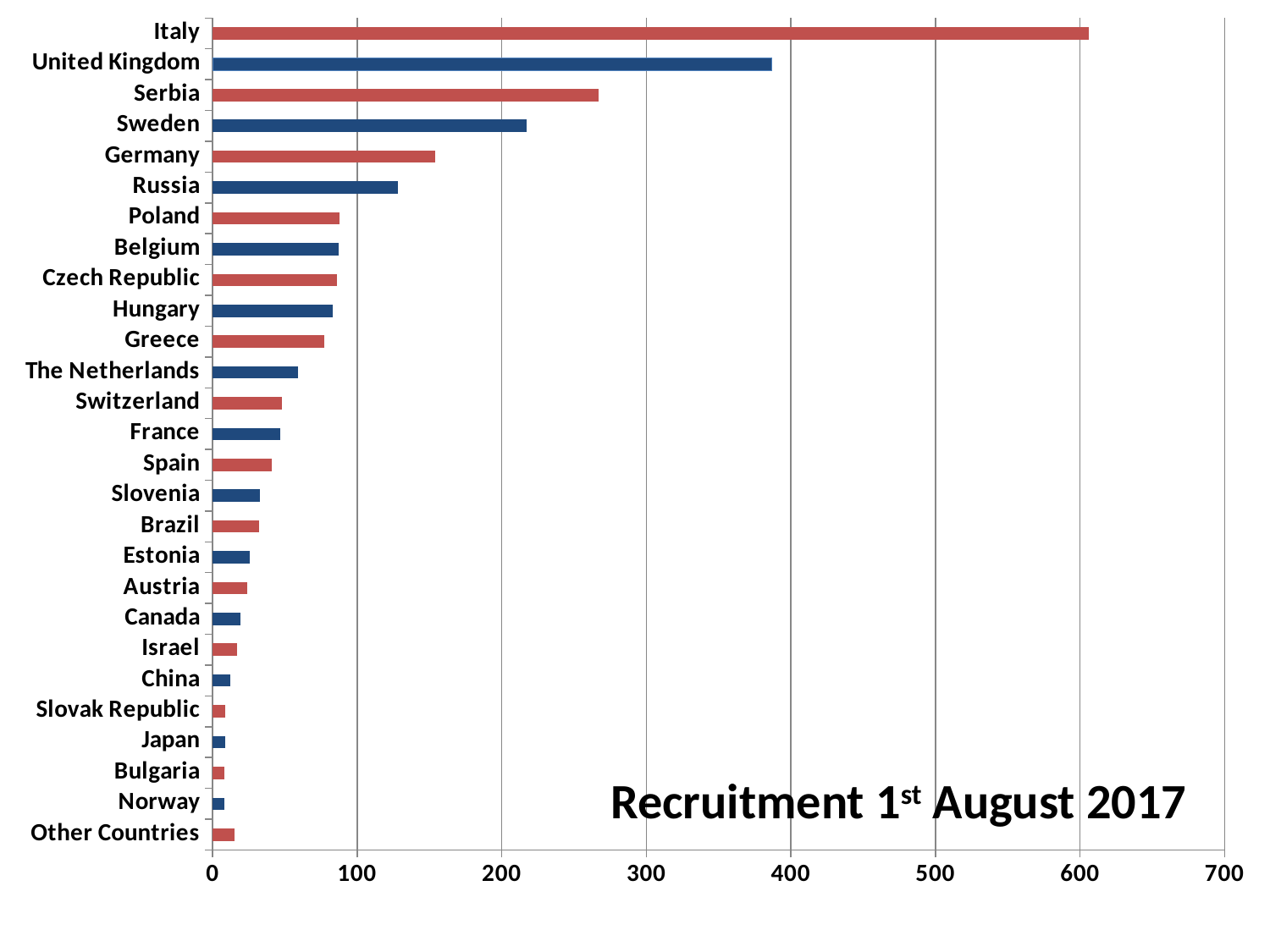
Which has the larger value, Germany or Russia? Germany Is the value for Italy greater or less than 500? greater Which category has the highest value? Italy Which has the larger value, Serbia or Sweden? Serbia Is the value for United Kingdom greater or less than 400? less How many categories (countries/groups) are plotted on the chart? 27 What kind of chart is shown on the slide? bar chart What is the title of the chart? Recruitment 1st August 2017 Is the value for Russia greater or less than 100? greater